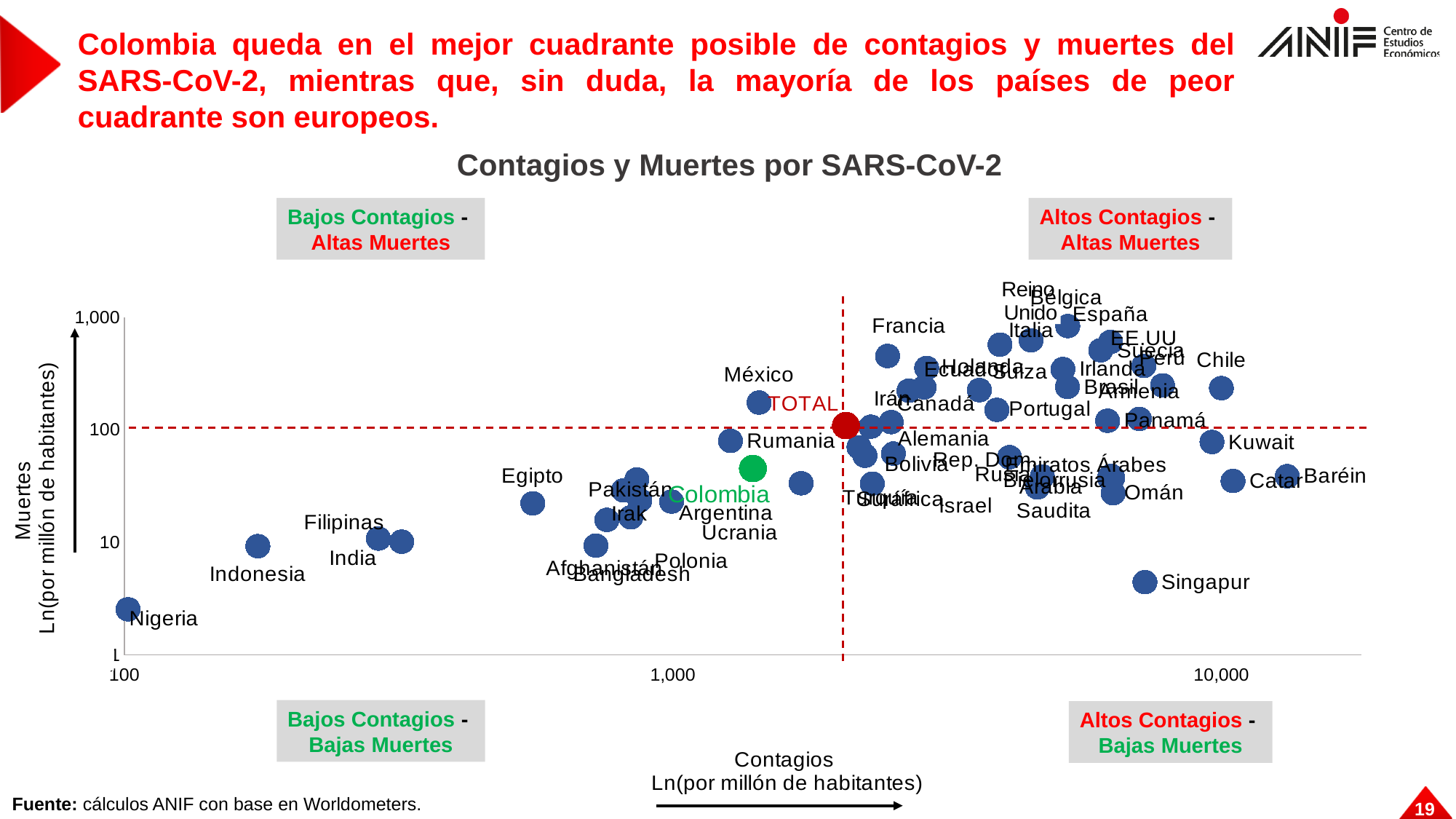
Which country has the highest value for Contagios on the chart? Baréin What is the title of the chart? Contagios y Muertes por SARS-CoV-2 Which country has a higher Muertes value, Francia or Indonesia? Francia Is the Contagios value for Baréin greater or less than 10,000? greater Is the Muertes value for Bélgica greater or less than 100? greater Is the Muertes value for Singapur greater or less than 10? less Which country has the lowest value for Muertes on the chart? Nigeria What kind of chart is shown on the slide? scatter chart What label is shown in the top-right quadrant of the chart? Altos Contagios - Altas Muertes Which country has a higher Contagios value, Kuwait or Egipto? Kuwait